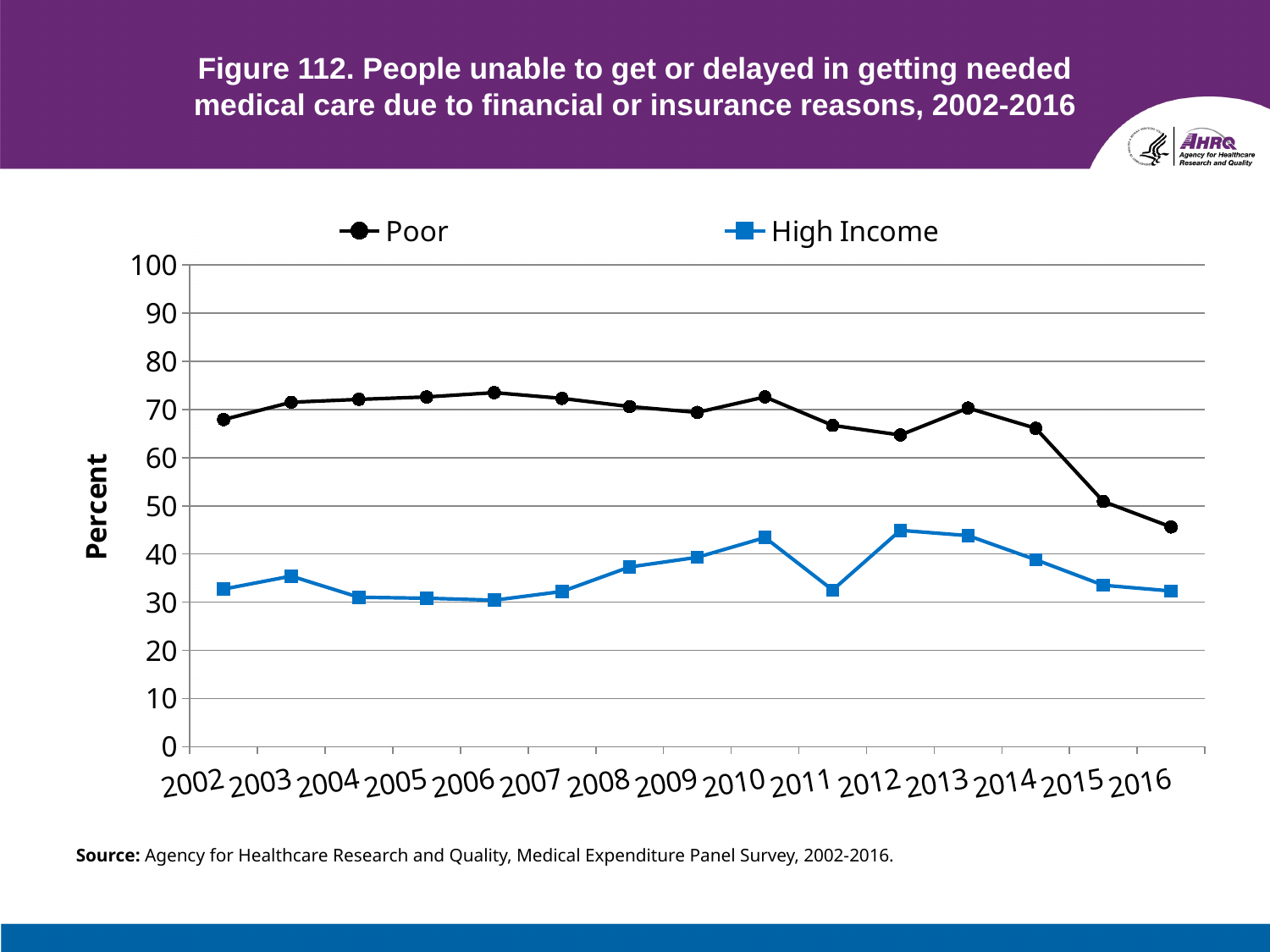
Does the High Income series rise or fall from 2006 to 2010? Rise In which year does the Poor series reach its lowest value? 2016 Is the value for Poor in 2006 greater or less than 70? greater What is the label on the vertical axis? Percent How many years are plotted along the x axis? 15 Does the Poor series rise or fall from 2013 to 2016? Fall Which series has the lowest value in 2016, Poor or High Income? High Income Is the value for High Income in 2010 greater or less than 40? greater Is the value for Poor in 2012 greater or less than 70? less How many series does the legend list? 2 What kind of chart is shown on the slide? Line chart